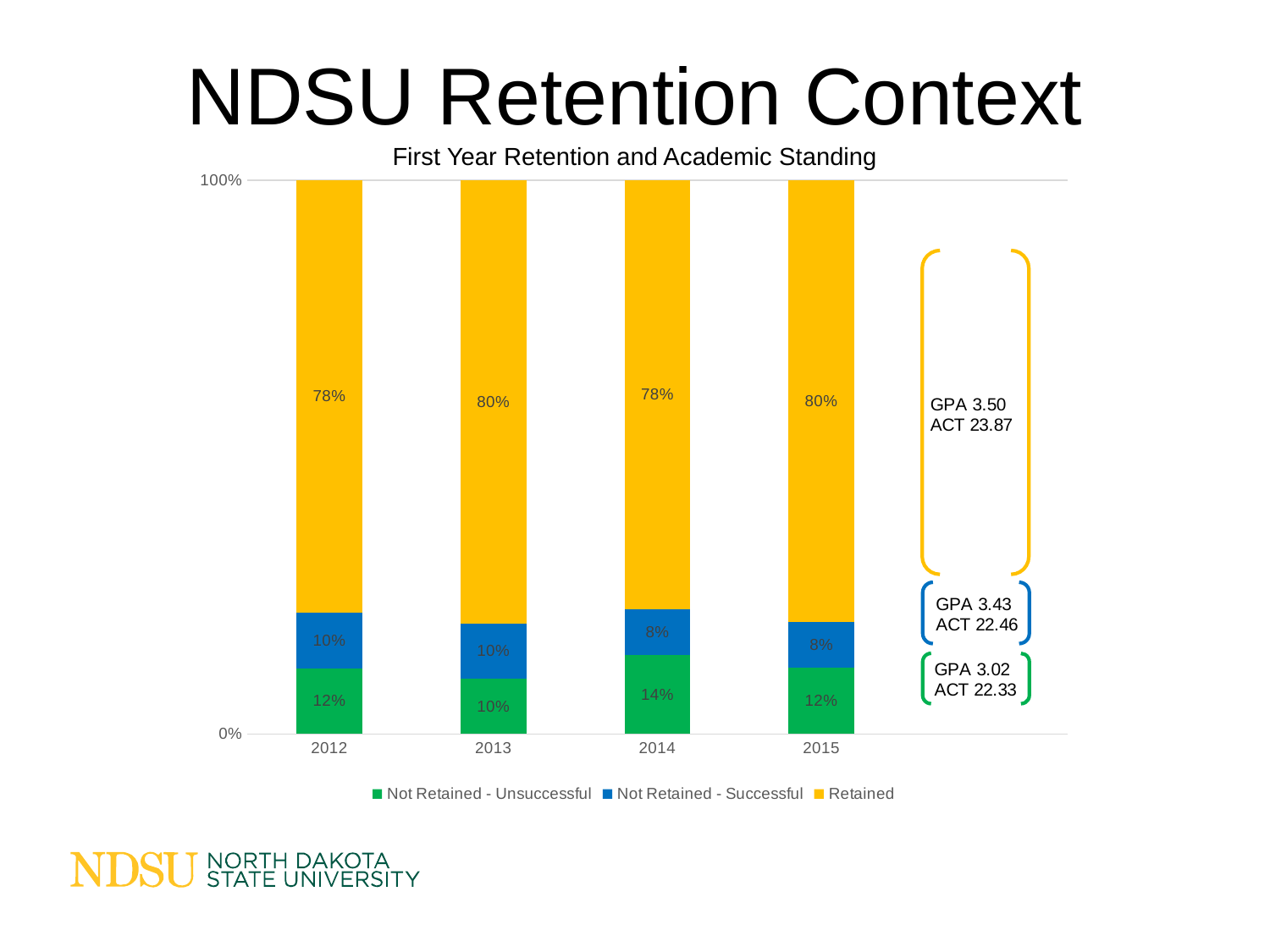
What is the difference between the Retained value for 2013 and the Retained value for 2012? 2% What is the Not Retained - Unsuccessful value for 2014? 14% How many series does the legend list? 3 What is the Not Retained - Successful value for 2015? 8% Which year has the lowest Not Retained - Unsuccessful value? 2013 What is the title of the chart? First Year Retention and Academic Standing Is the Not Retained - Successful value larger in 2012 or in 2014? 2012 What is the Retained value for 2013? 80% How many years are shown on the x axis? 4 Which year has the highest Not Retained - Unsuccessful value? 2014 What is the total of the stacked bar for 2015? 100% What kind of chart is shown on the slide? Stacked bar chart